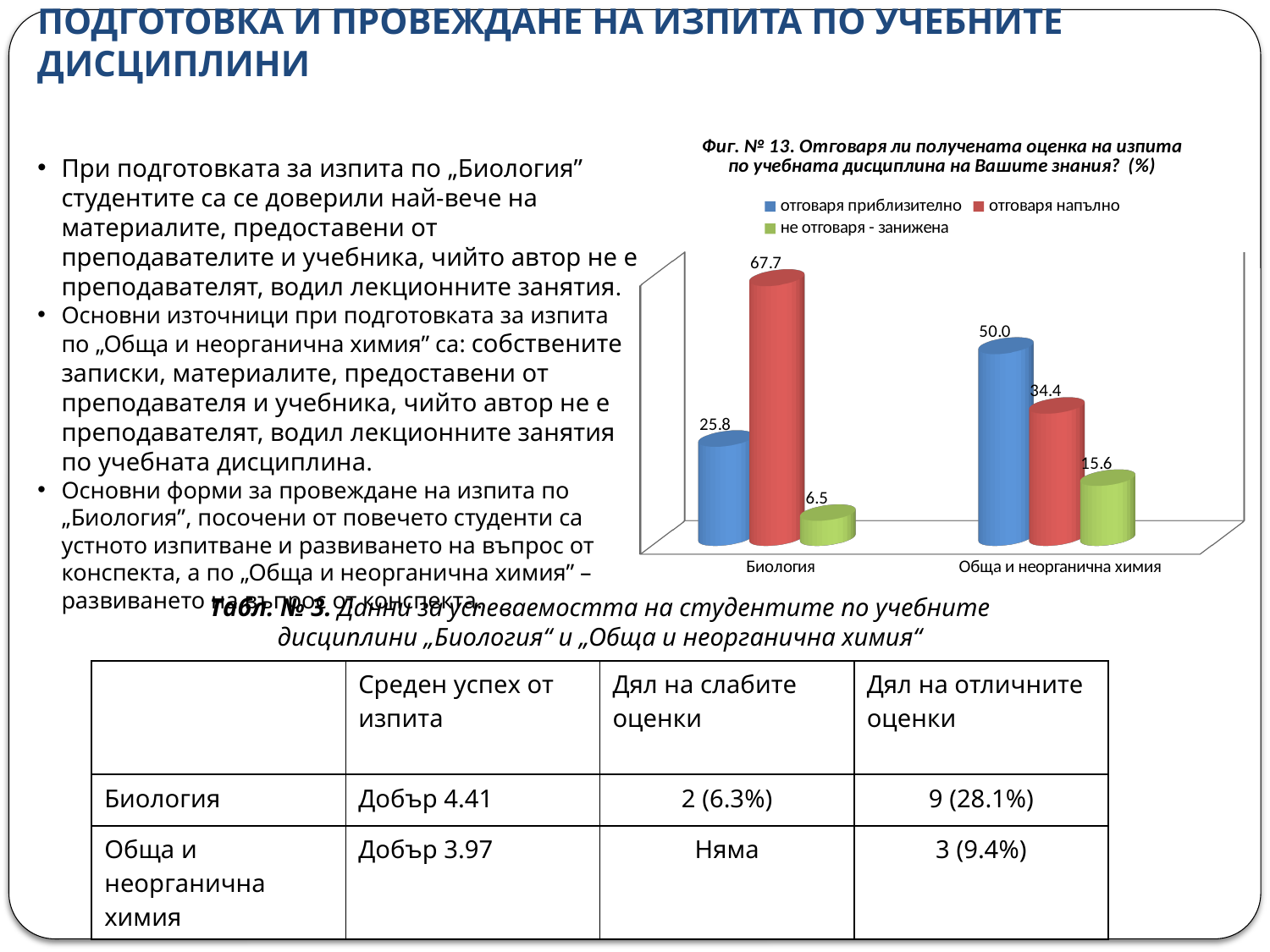
Which is larger: "отговаря приблизително" for "Биология" or for "Обща и неорганична химия"? Обща и неорганична химия Which series has the lowest value in the "Обща и неорганична химия" category? не отговаря - занижена How many series does the chart legend list? 3 What value does the chart show for "не отговаря - занижена" in the "Биология" category? 6.5 What value does the chart show for "отговаря приблизително" in the "Обща и неорганична химия" category? 50.0 What value does the chart show for "отговаря напълно" in the "Биология" category? 67.7 How many categories are shown on the x axis of the chart? 2 What is the difference between the "отговаря напълно" values for "Биология" and "Обща и неорганична химия"? 33.3 What is the figure number given in the chart title? Фиг. № 13 What kind of chart is shown on the slide? bar chart Which series has the highest value in the "Биология" category? отговаря напълно What value does the chart show for "не отговаря - занижена" in the "Обща и неорганична химия" category? 15.6